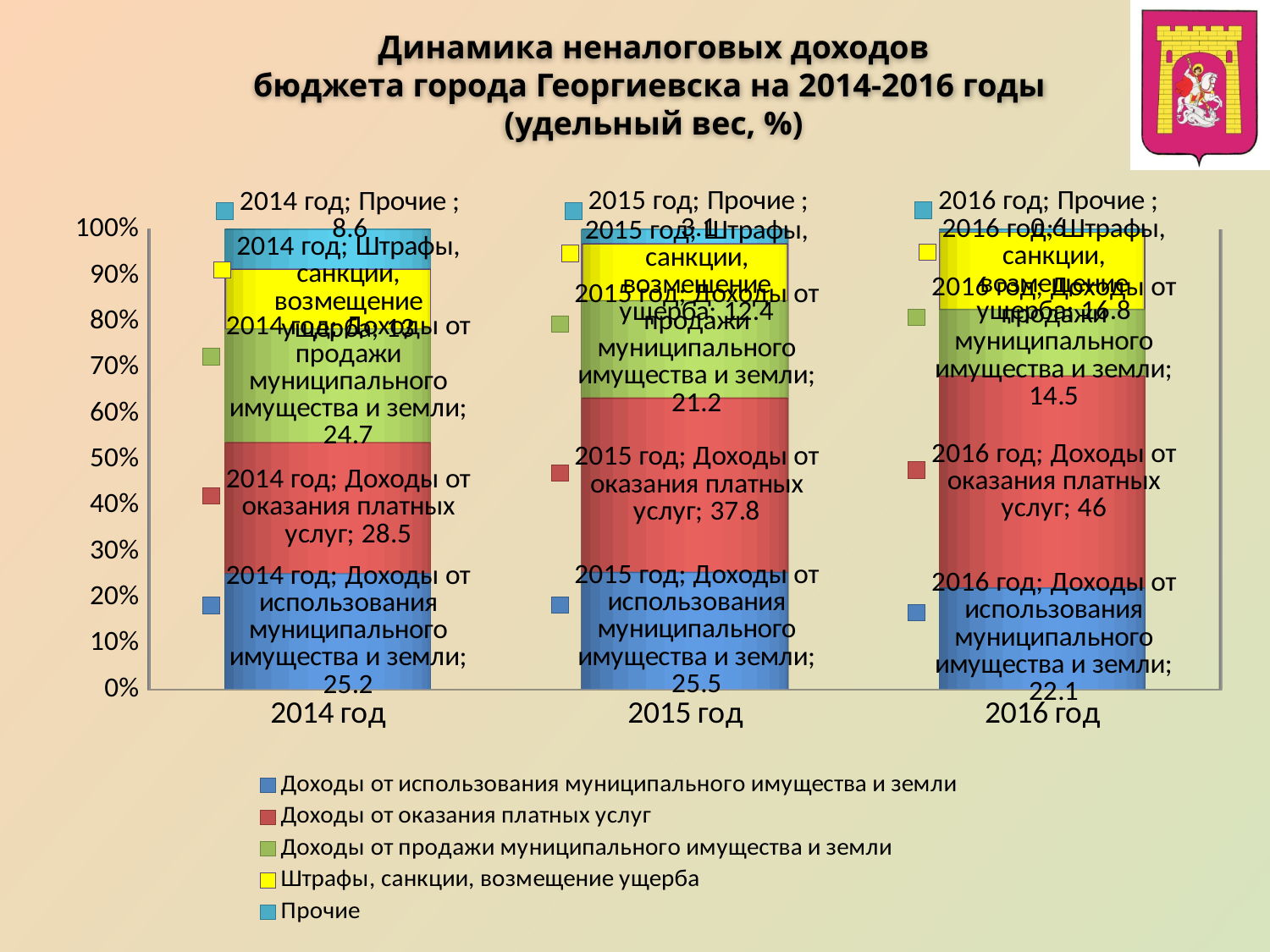
Which colour represents 'Прочие' in the legend? Light blue In which year is the share of 'Доходы от оказания платных услуг' the highest? 2016 год How many series does the legend list? 5 What is the share of 'Доходы от продажи муниципального имущества и земли' in 2015 год? 21.2 How many years (categories) are shown on the x axis? 3 What kind of chart is shown on the slide? Stacked bar chart What is the share of 'Доходы от использования муниципального имущества и земли' in 2014 год? 25.2 By how much did the share of 'Доходы от оказания платных услуг' change from 2014 год (28.5) to 2015 год (37.8)? 9.3 What is the share of 'Штрафы, санкции, возмещение ущерба' in 2015 год? 12.4 In which year is the share of 'Доходы от продажи муниципального имущества и земли' the lowest? 2016 год What is the share of 'Доходы от оказания платных услуг' in 2016 год? 46 Does the share of 'Доходы от оказания платных услуг' rise or fall from 2014 год to 2016 год? Rises